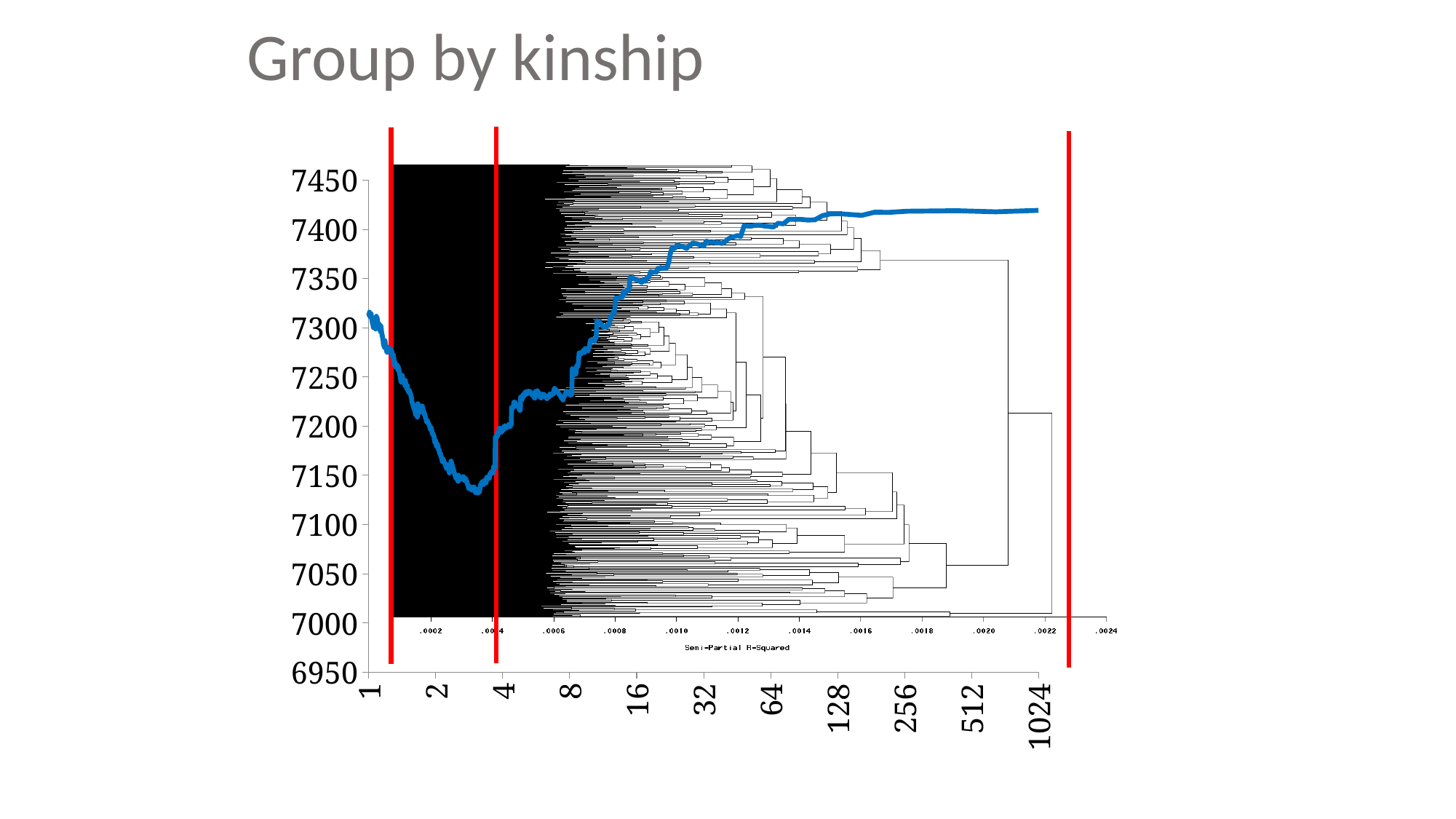
What kind of chart is the blue plotted series on the slide? line chart Is the lowest point of the blue line greater or less than 7150? less What is the title of the slide containing the chart? Group by kinship Is the value of the blue line at x = 2 greater or less than 7250? less What is the highest tick label on the y axis of the chart? 7450 Is the value of the blue line at x = 8 greater or less than 7300? less Is the value of the blue line higher at x = 1024 or at x = 1? x = 1024 How many tick labels are shown on the x axis of the chart? 11 Does the blue line rise or fall between x = 1 and x = 4? fall